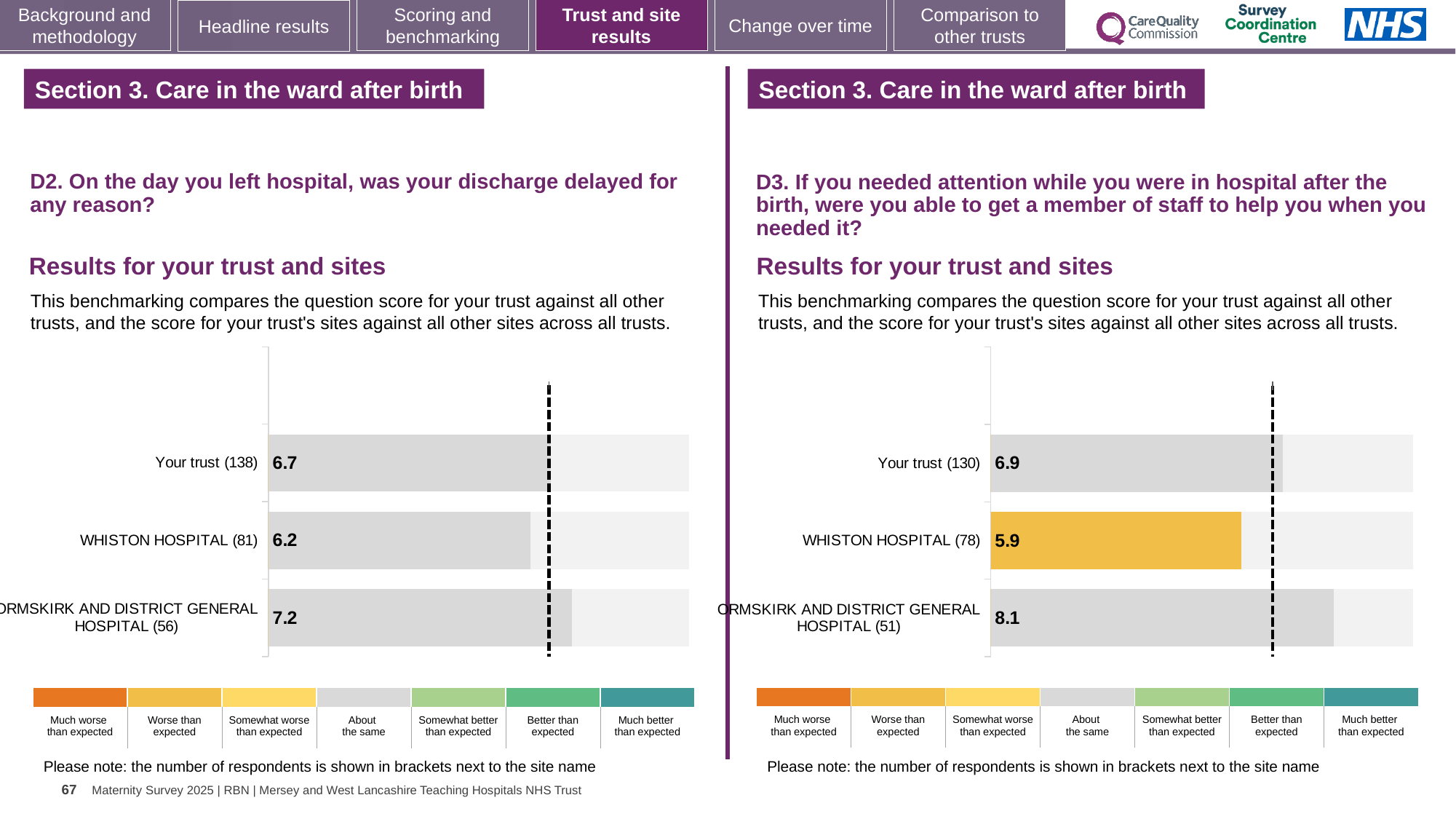
In the left chart (D2), what is the score for WHISTON HOSPITAL? 6.2 In the right chart (D3), what is the difference between the scores for ORMSKIRK AND DISTRICT GENERAL HOSPITAL and Your trust? 1.2 In the right chart (D3), what is the score for ORMSKIRK AND DISTRICT GENERAL HOSPITAL? 8.1 In the right chart (D3), what is the score for WHISTON HOSPITAL? 5.9 In the left chart (D2), which site or trust has the highest score? ORMSKIRK AND DISTRICT GENERAL HOSPITAL In the left chart (D2), what is the difference between the scores for ORMSKIRK AND DISTRICT GENERAL HOSPITAL and WHISTON HOSPITAL? 1.0 In the right chart (D3), which has the larger score, Your trust or WHISTON HOSPITAL? Your trust What type of chart is used on the right side of the slide (D3)? Bar chart In the right chart (D3), how many respondents are shown in brackets for Your trust? 130 In the right chart (D3), which site or trust has the lowest score? WHISTON HOSPITAL How many bars are shown in the left chart (D2)? 3 In the left chart (D2), what is the score for Your trust? 6.7